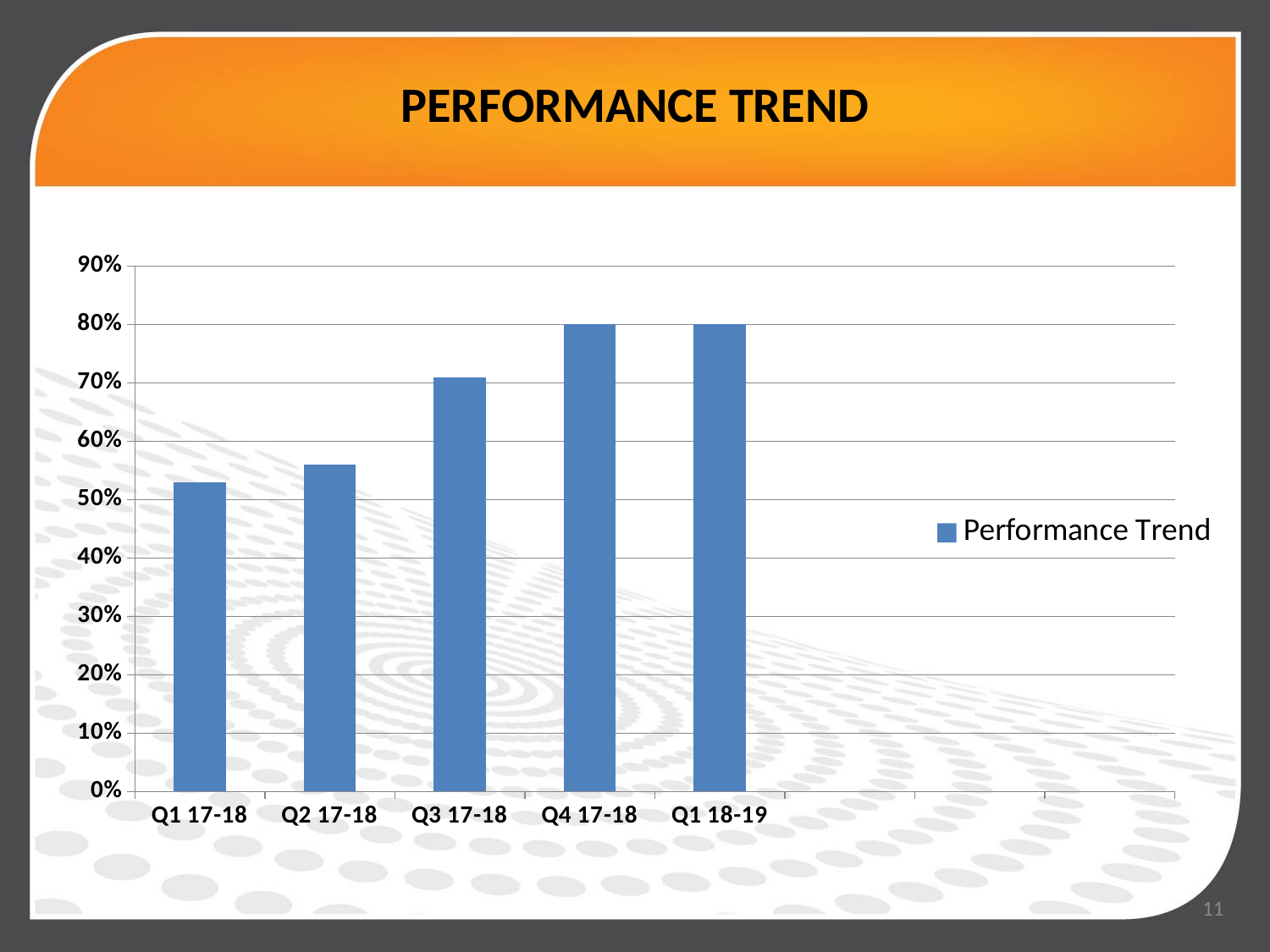
Is the value for Q3 17-18 greater or less than 60%? greater Which category has the lowest value in the chart? Q1 17-18 How many series does the chart legend list? 1 Which is larger, the value for Q1 17-18 or the value for Q4 17-18? Q4 17-18 What is the name of the series shown in the chart legend? Performance Trend Do the values generally rise or fall from Q1 17-18 to Q1 18-19? rise What kind of chart is shown on the slide? bar chart Is the value for Q2 17-18 greater or less than 60%? less What is the title of the slide containing the chart? PERFORMANCE TREND How many categories are shown on the x axis of the chart? 5 Which is larger, the value for Q2 17-18 or the value for Q3 17-18? Q3 17-18 Is the value for Q1 17-18 greater or less than 50%? greater